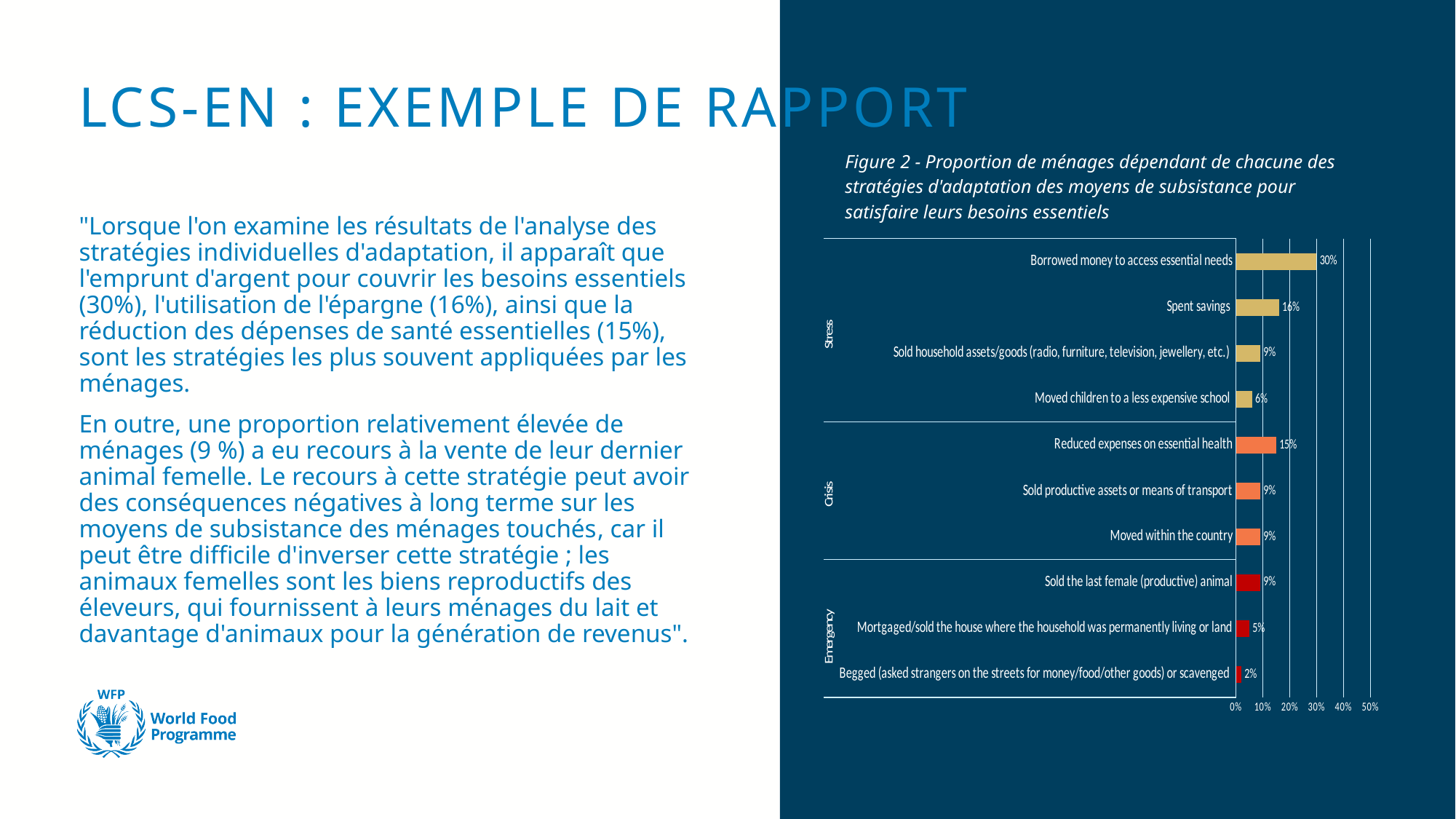
What is the difference between 'Borrowed money to access essential needs' and 'Spent savings'? 14% Which strategy has the lowest proportion of households? Begged (asked strangers on the streets for money/food/other goods) or scavenged Which is larger: 'Moved children to a less expensive school' or 'Mortgaged/sold the house where the household was permanently living or land'? Moved children to a less expensive school What percentage of households borrowed money to access essential needs? 30% What is the value for 'Spent savings'? 16% What are the three group labels shown along the left side of the chart? Stress, Crisis, Emergency What kind of chart is shown on the slide? Bar chart What is the value for 'Sold the last female (productive) animal'? 9% What is the value for 'Reduced expenses on essential health'? 15% Which strategy has the highest proportion of households? Borrowed money to access essential needs How many strategies (bars) are shown in the chart? 10 What is the value for 'Begged (asked strangers on the streets for money/food/other goods) or scavenged'? 2%